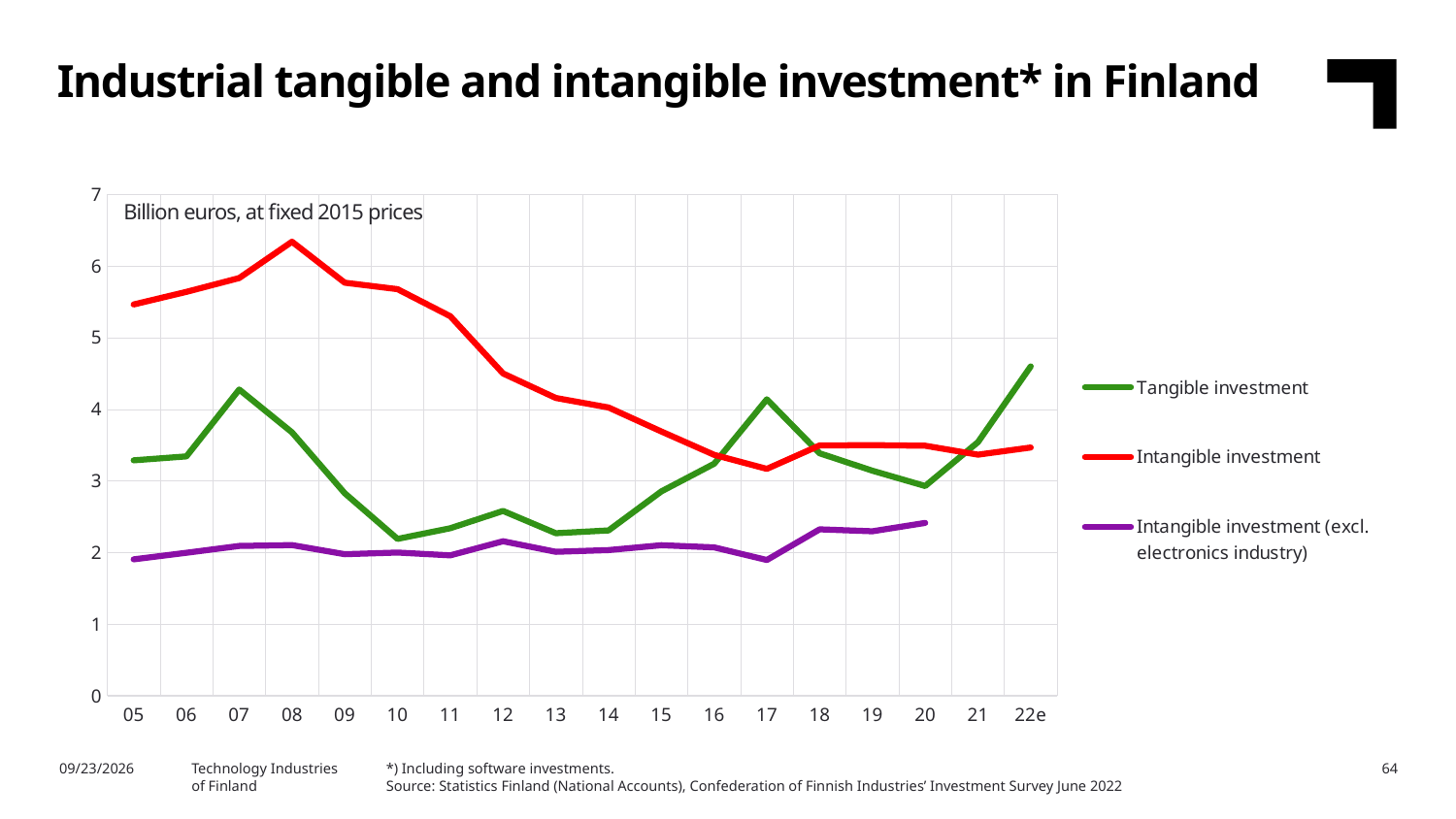
In 05, which is larger: tangible investment or intangible investment? Intangible investment What type of chart is shown on the slide? line chart How many series does the legend list? 3 How many years are shown on the x axis? 18 In which year does tangible investment reach its highest value? 22e In which year is intangible investment at its lowest? 17 Does intangible investment rise or fall between 08 and 17? fall In which year does intangible investment reach its highest value? 08 Is the value for tangible investment in 10 greater or less than 3? less Is the value for intangible investment (excl. electronics industry) in 20 greater or less than 3? less In 22e, which is larger: tangible investment or intangible investment? Tangible investment Is the value for intangible investment in 08 greater or less than 6? greater